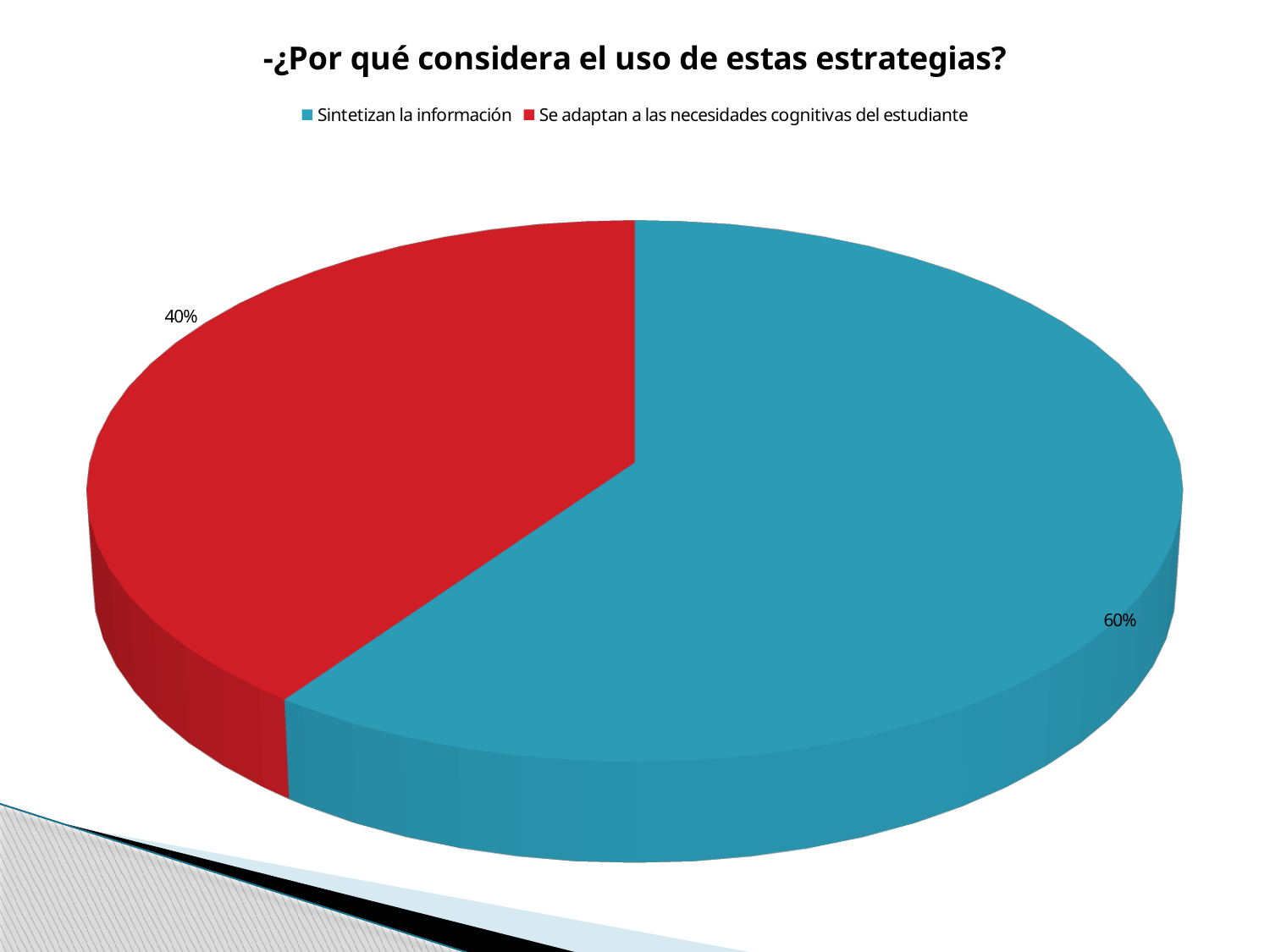
Which category has the largest slice? Sintetizan la información What is the title of the chart? -¿Por qué considera el uso de estas estrategias? Which is larger: 'Sintetizan la información' or 'Se adaptan a las necesidades cognitivas del estudiante'? Sintetizan la información How many entries does the legend list? 2 What share of the pie is 'Sintetizan la información'? 60% Which category has the smallest slice? Se adaptan a las necesidades cognitivas del estudiante What colour is the slice for 'Se adaptan a las necesidades cognitivas del estudiante'? red What kind of chart is shown on the slide? pie chart What is the difference in percentage points between 'Sintetizan la información' and 'Se adaptan a las necesidades cognitivas del estudiante'? 20% How many slices does the pie chart have? 2 What share of the pie is 'Se adaptan a las necesidades cognitivas del estudiante'? 40%